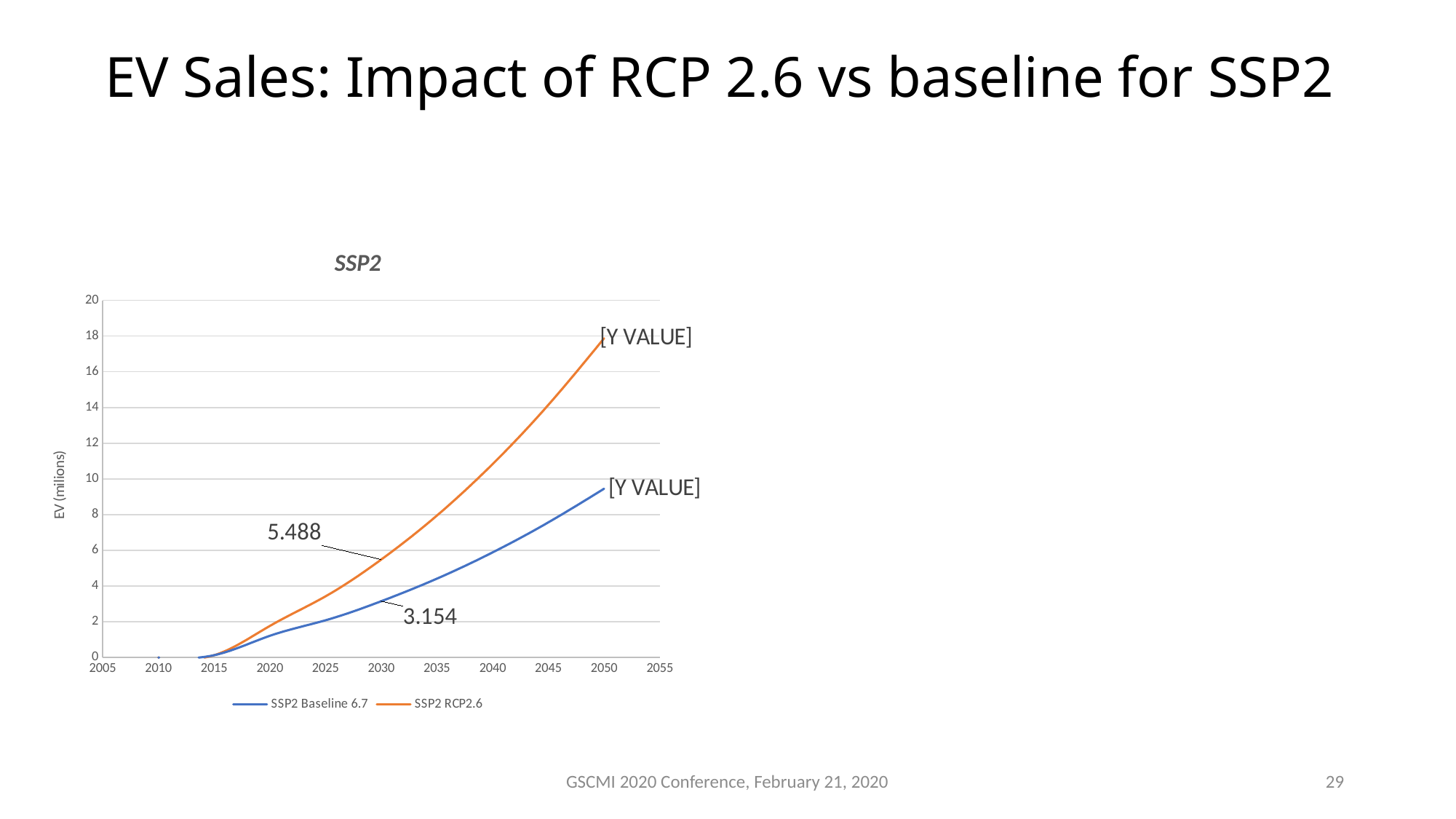
What is the labelled value for SSP2 Baseline 6.7 in 2030? 3.154 Is the value for SSP2 Baseline 6.7 in 2050 greater or less than 10? less Do the values of both series rise or fall from 2015 to 2050? rise What is the difference between the labelled 2030 values of SSP2 RCP2.6 and SSP2 Baseline 6.7? 2.334 Is the value for SSP2 Baseline 6.7 in 2040 greater or less than 8? less What is the labelled value for SSP2 RCP2.6 in 2030? 5.488 How many series does the legend list? 2 What is the label on the vertical axis of the chart? EV (milions) In 2030, which series has the larger value, SSP2 RCP2.6 or SSP2 Baseline 6.7? SSP2 RCP2.6 What kind of chart is shown on the slide? line chart Which series reaches the higher value in 2050? SSP2 RCP2.6 Is the value for SSP2 RCP2.6 in 2050 greater or less than 16? greater